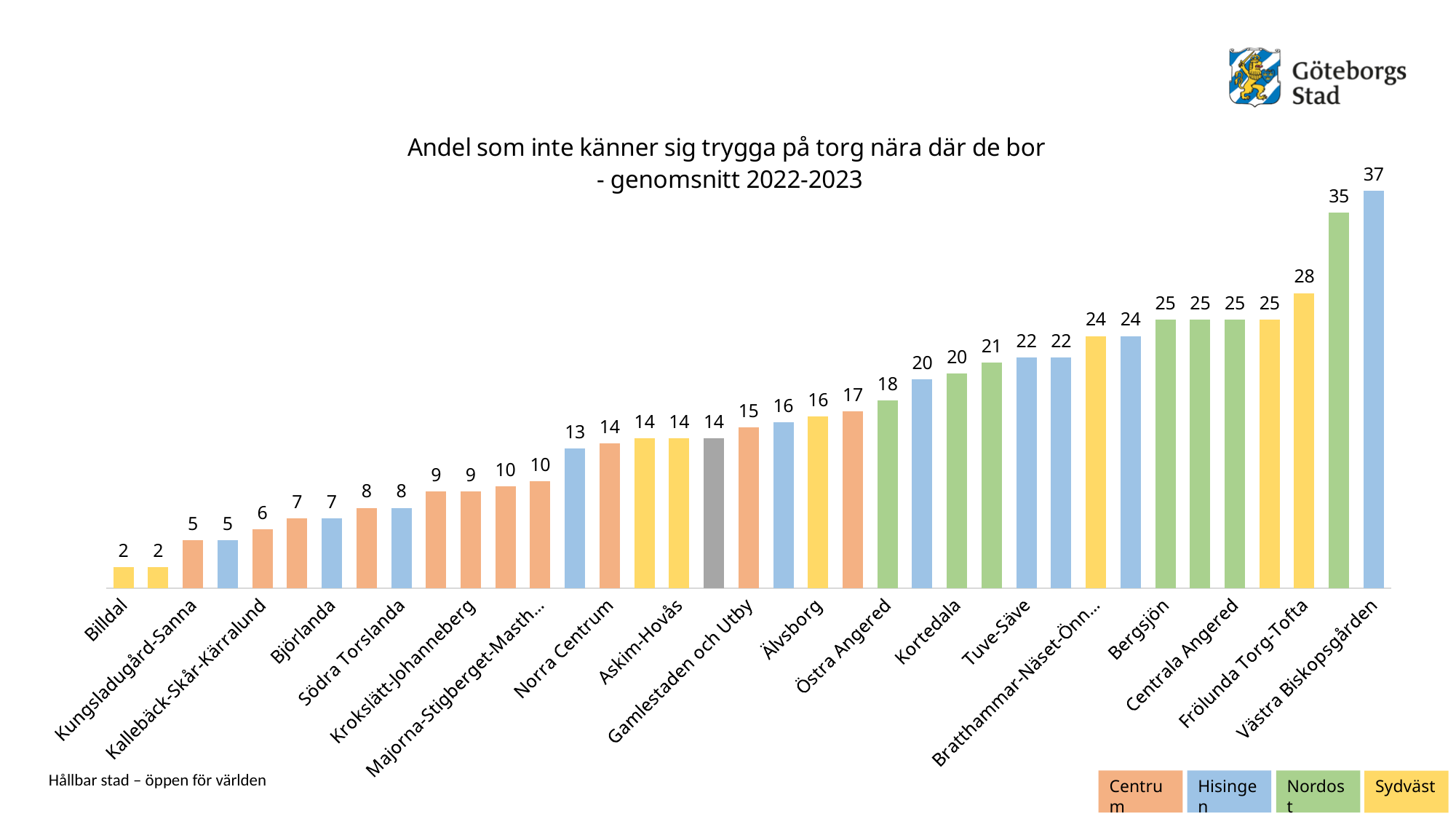
What is the difference between the values for Västra Biskopsgården and Frölunda Torg-Tofta? 9 What is the value for Björlanda? 7 Which has a larger value, Tuve-Säve or Kortedala? Tuve-Säve What type of chart is shown on the slide? bar chart Which legend entry is shown in green? Nordost Which area has the highest value in the chart? Västra Biskopsgården What is the value for Billdal? 2 What is the value for Frölunda Torg-Tofta? 28 Do the values rise or fall from left to right along the x axis? rise What is the value for Kortedala? 20 What is the value for Västra Biskopsgården? 37 How many series does the legend list? 4